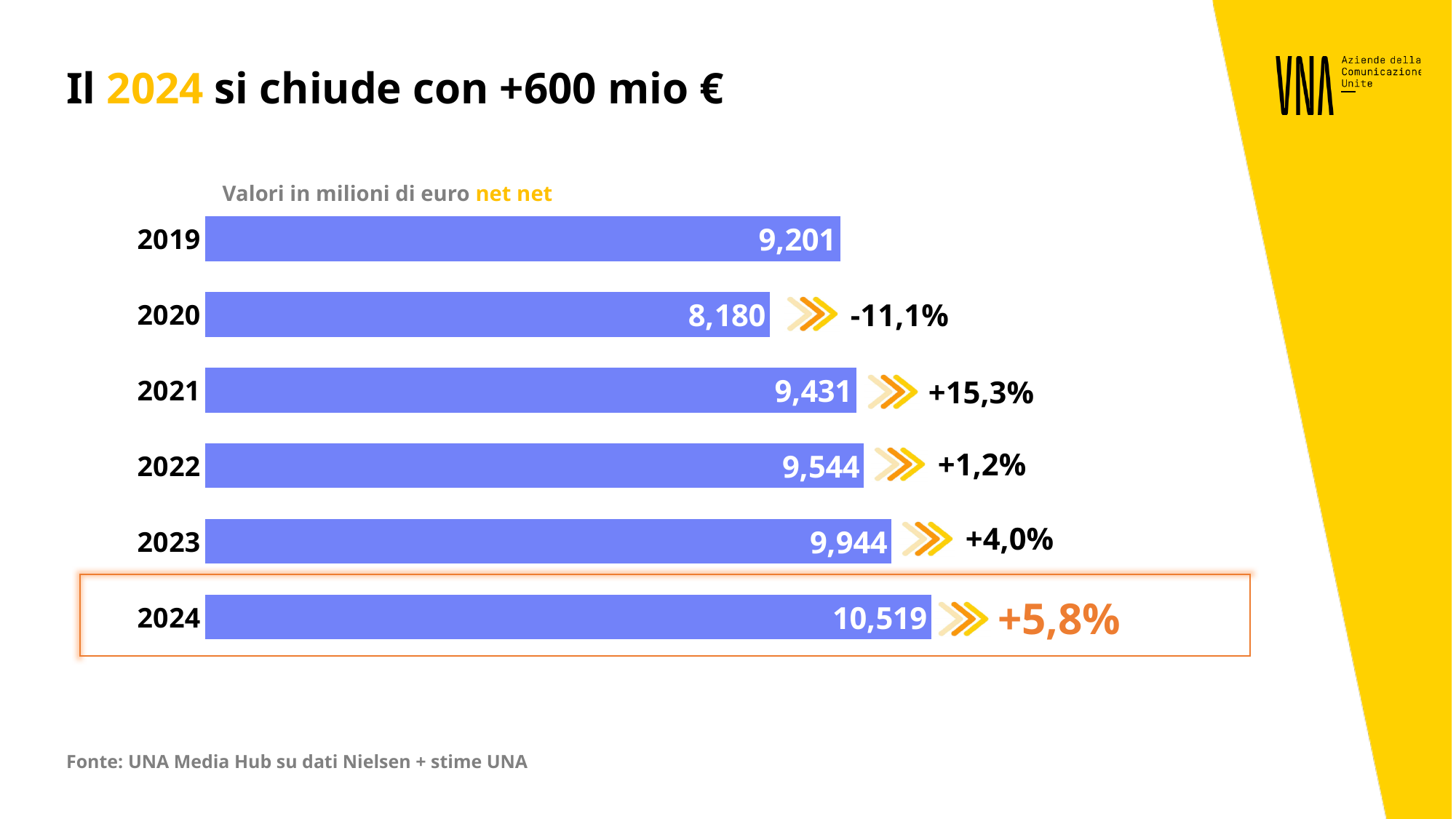
Which year has the lowest value? 2020 What is the value for 2019? 9,201 What is the value for 2024? 10,519 What is the difference between the values for 2019 and 2020? 1,021 What percentage change is shown next to the 2021 bar? +15,3% How many years are shown in the chart? 6 Which is larger, the value for 2021 or the value for 2022? 2022 What kind of chart is shown on the slide? bar chart Which year has the highest value? 2024 Do the values rise or fall from 2020 to 2024? rise What is the difference between the values for 2024 and 2023? 575 What is the value for 2020? 8,180